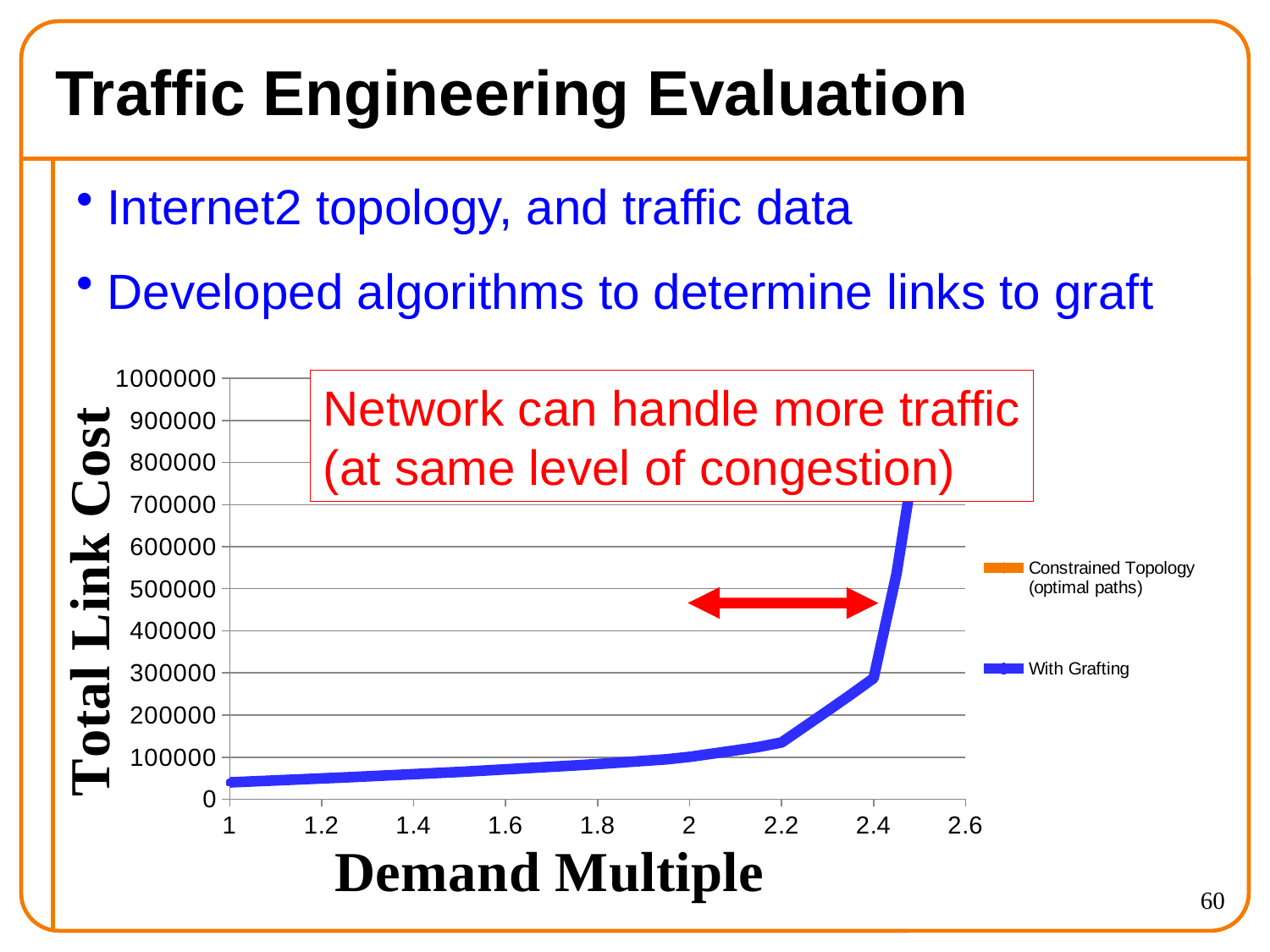
What is the title of the x axis of the chart? Demand Multiple What kind of chart is shown on the slide? line chart How many series does the chart legend list? 2 Is the With Grafting value at a demand multiple of 1 greater or less than 100000? less Is the With Grafting value at a demand multiple of 1.6 greater or less than 100000? less Is the With Grafting value at a demand multiple of 2.4 greater or less than 200000? greater What is the title of the y axis of the chart? Total Link Cost What is the highest value shown on the y axis of the chart? 1000000 Does the With Grafting line rise or fall as the demand multiple increases? rise Which is larger for the With Grafting series: the value at a demand multiple of 2.4 or the value at 2.2? 2.4